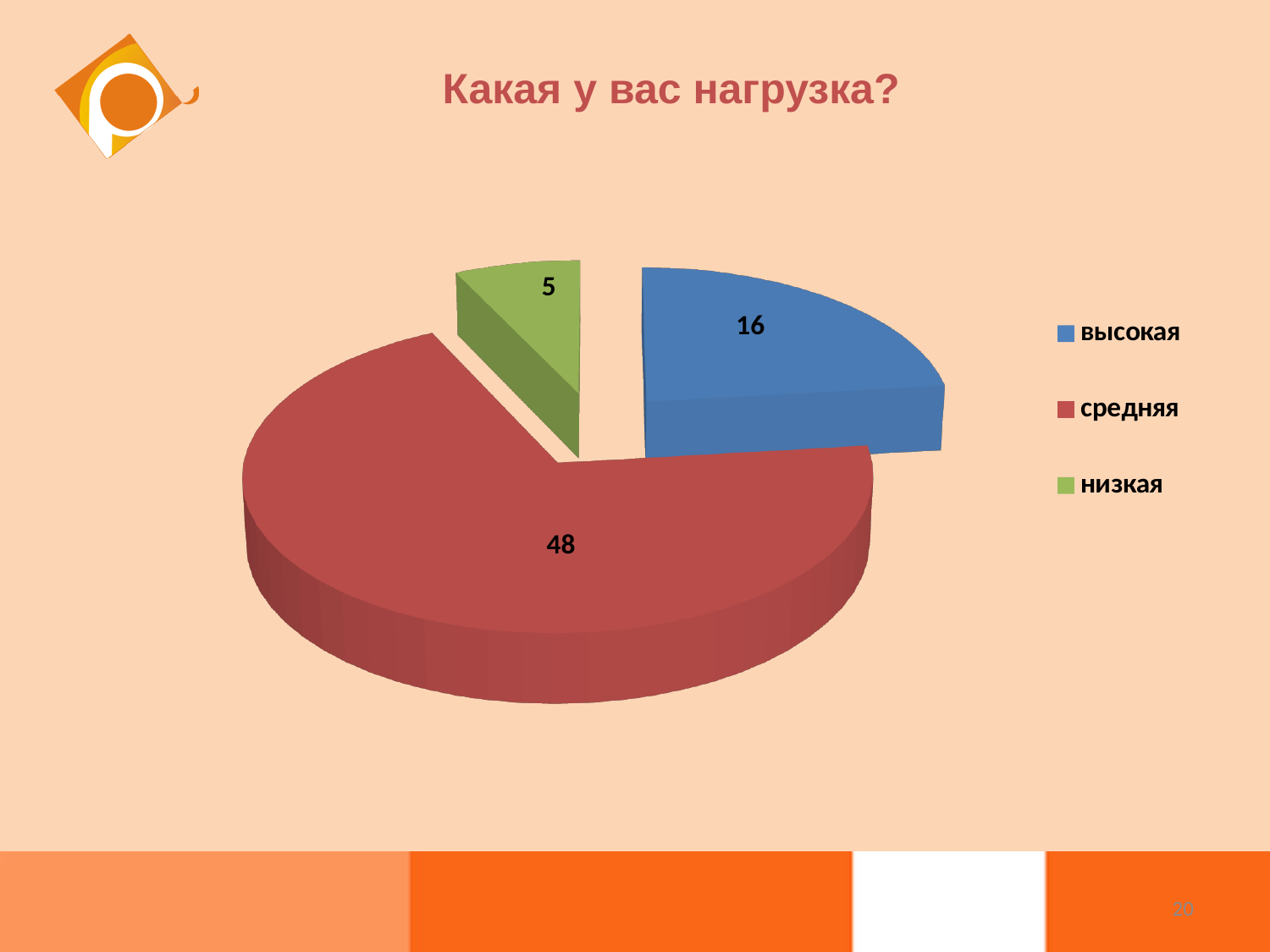
Which category has the largest slice of the pie? средняя Which category has the smallest slice of the pie? низкая What is the value for the "высокая" slice? 16 Which is larger, the value for "высокая" or the value for "низкая"? высокая What is the sum of all the values shown in the pie chart? 69 What is the value for the "низкая" slice? 5 How many slices does the pie chart have? 3 What is the difference between the values for "высокая" and "низкая"? 11 What is the value for the "средняя" slice? 48 What is the difference between the values for "средняя" and "высокая"? 32 What is the title of the chart on the slide? Какая у вас нагрузка? What kind of chart is shown on the slide? pie chart